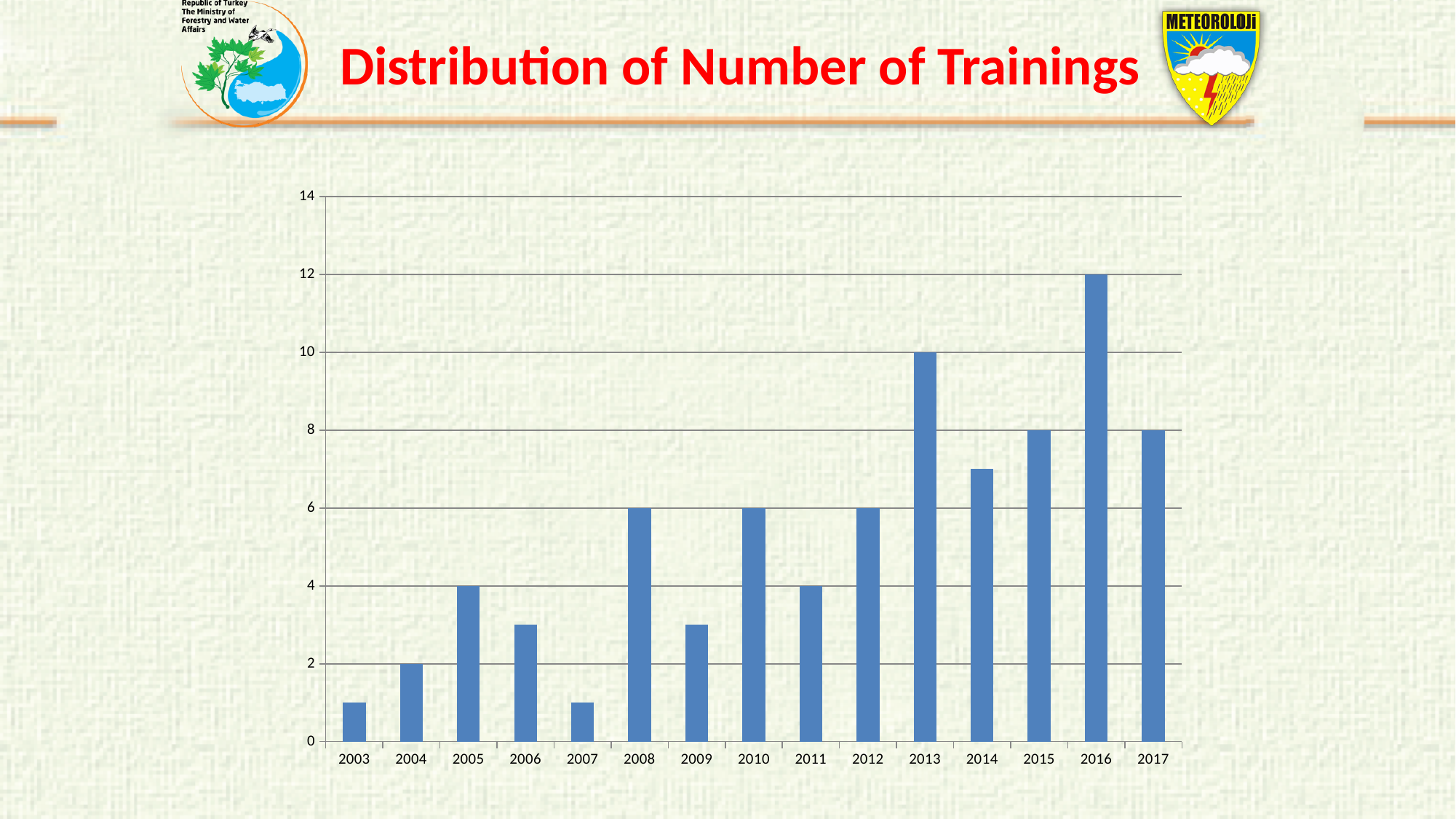
Is the value for 2007 greater or less than 2? less What is the number of trainings in 2016? 12 How many years are shown on the x axis of the chart? 15 What is the difference in the number of trainings between 2016 and 2013? 2 What is the number of trainings in 2004? 2 What is the number of trainings in 2013? 10 Is the value for 2014 greater or less than 6? greater Which year has the highest number of trainings? 2016 Which year has more trainings, 2013 or 2015? 2013 What is the number of trainings in 2015? 8 What is the title of the chart? Distribution of Number of Trainings What type of chart is shown on the slide? Bar chart